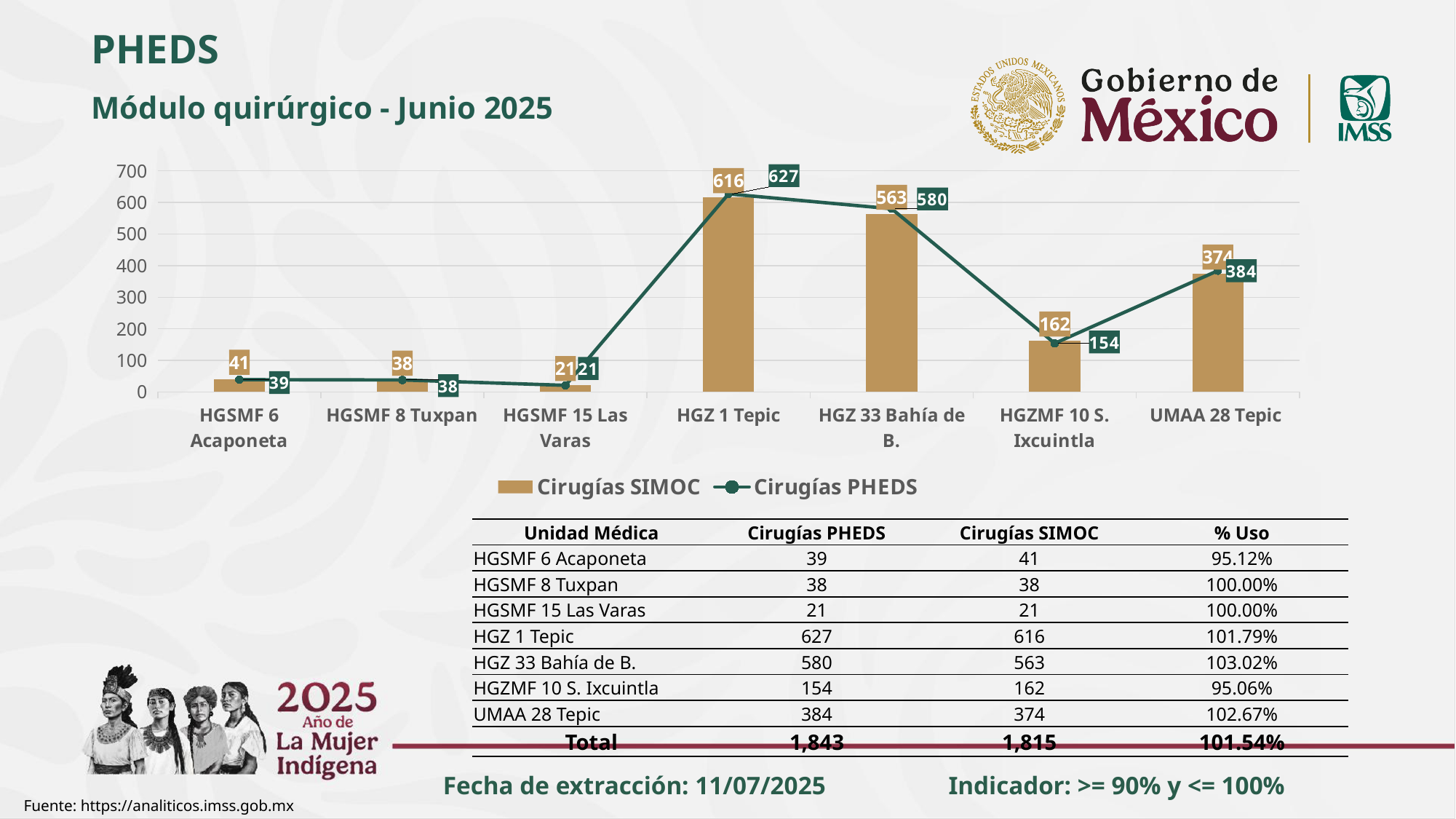
Which unit has the highest Cirugías SIMOC value? HGZ 1 Tepic What is the Cirugías PHEDS value for HGZMF 10 S. Ixcuintla? 154 How many series does the chart legend list? 2 What is the difference between Cirugías PHEDS and Cirugías SIMOC for HGZ 33 Bahía de B.? 17 Is the Cirugías SIMOC value for UMAA 28 Tepic greater or less than 300? greater What is the Cirugías SIMOC value for HGZ 1 Tepic? 616 Which unit has the lowest Cirugías PHEDS value? HGSMF 15 Las Varas What is the Cirugías PHEDS value for UMAA 28 Tepic? 384 Which series is drawn as a line with markers in the chart? Cirugías PHEDS Which is larger for HGZMF 10 S. Ixcuintla, Cirugías SIMOC or Cirugías PHEDS? Cirugías SIMOC How many medical units are shown on the x axis of the chart? 7 What kind of chart is used to show Cirugías SIMOC? Bar chart